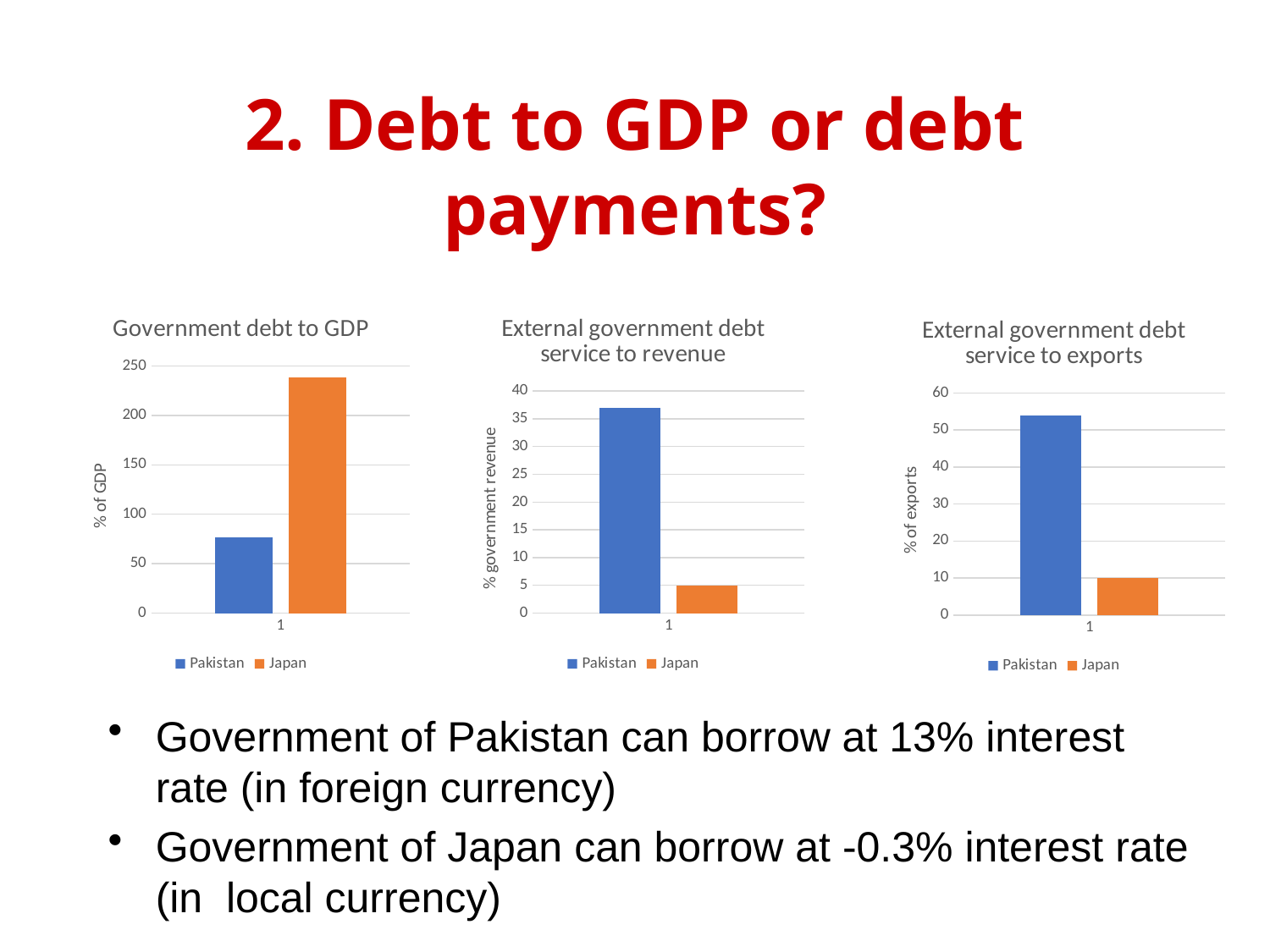
In the 'External government debt service to revenue' chart, is the value for Pakistan greater or less than 30? greater In the 'External government debt service to revenue' chart, which country has the lower value? Japan In the 'External government debt service to revenue' chart, is the value for Japan greater or less than 10? less What is the y-axis label of the 'External government debt service to revenue' chart? % government revenue What kind of chart is the 'External government debt service to exports' chart? Bar chart In the 'Government debt to GDP' chart, which country has the higher value? Japan In the 'External government debt service to exports' chart, is the value for Japan greater or less than 20? less How many series does the legend of the 'Government debt to GDP' chart list? 2 In the 'External government debt service to exports' chart, which country has the higher value? Pakistan